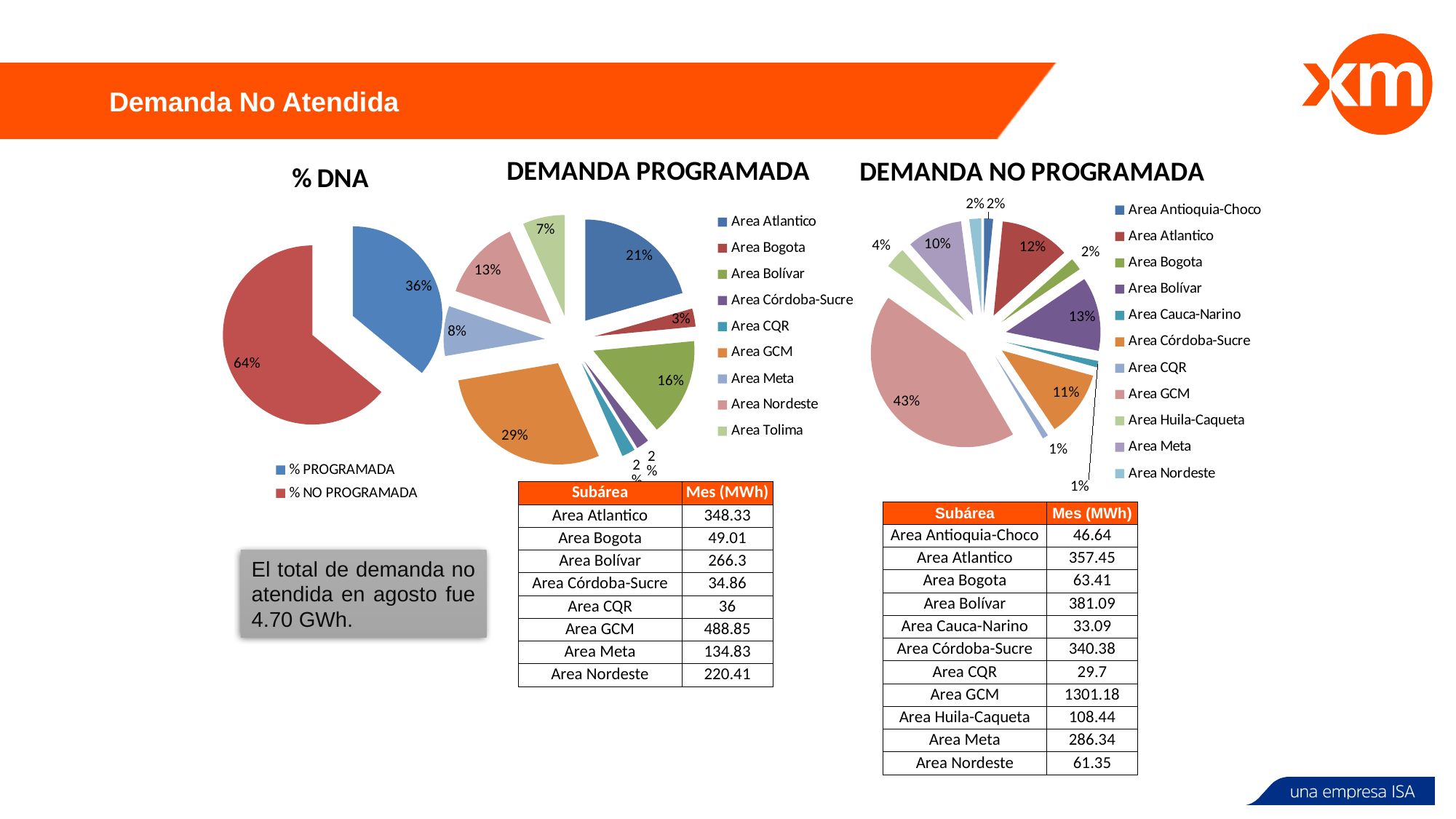
How many entries does the legend of the DEMANDA PROGRAMADA chart list? 9 In the DEMANDA NO PROGRAMADA chart, which is larger, Area Bolívar or Area Meta? Area Bolívar In the DEMANDA PROGRAMADA chart, which area has the largest slice? Area GCM In the % DNA chart, what share is % PROGRAMADA? 36% In the DEMANDA NO PROGRAMADA chart, which area has the largest slice? Area GCM How many entries does the legend of the DEMANDA NO PROGRAMADA chart list? 11 In the DEMANDA PROGRAMADA chart, what is the difference in percentage points between Area Bolívar and Area Nordeste? 3 In the DEMANDA PROGRAMADA chart, what share does Area Atlantico have? 21% In the % DNA chart, what share is % NO PROGRAMADA? 64% What kind of chart is the % DNA chart? Pie chart